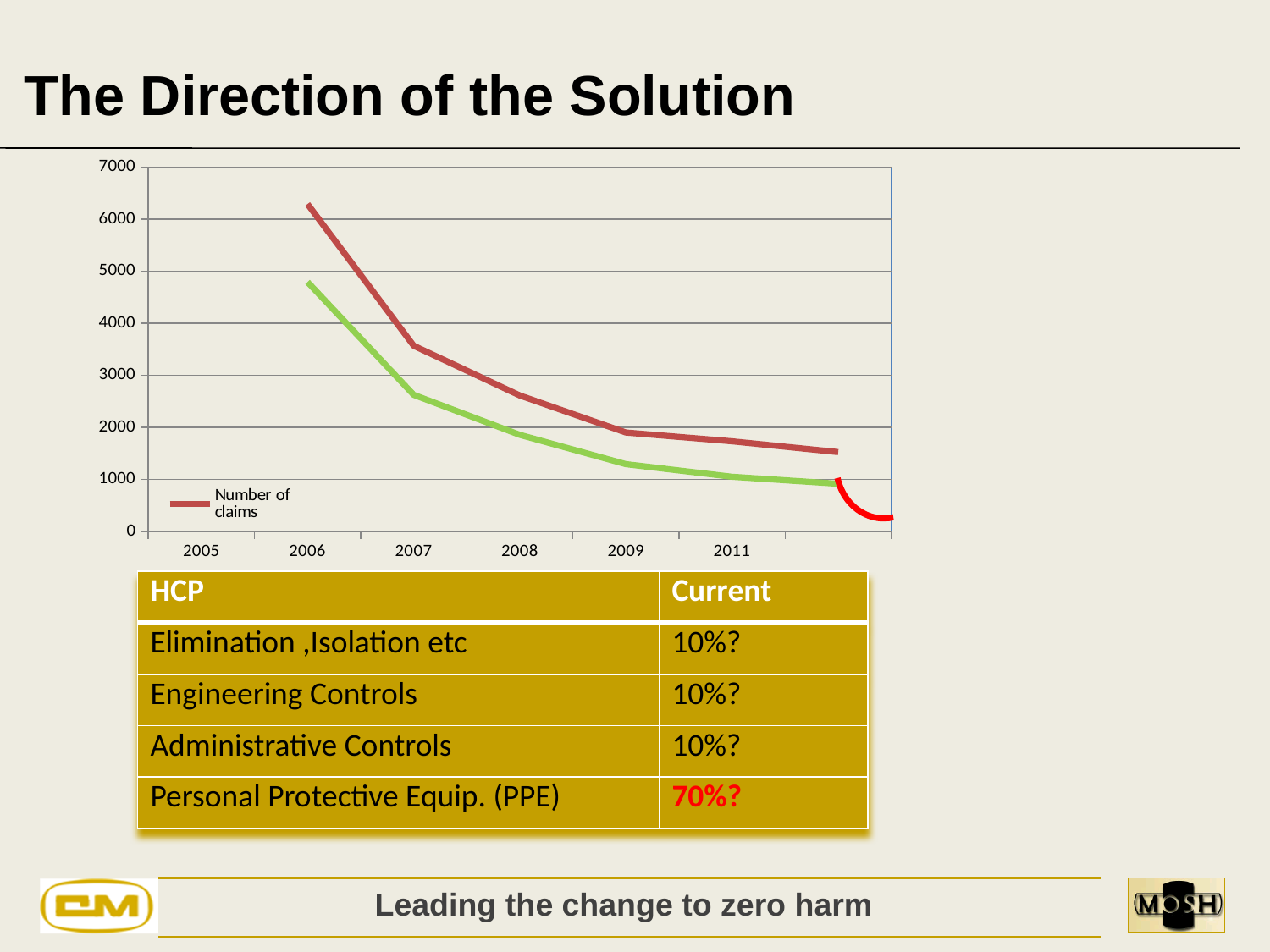
Is the value of the 'Number of claims' line in 2009 greater or less than 3000? less Is the value of the 'Number of claims' line in 2007 greater or less than 3000? greater How many year labels are shown on the x axis of the chart? 6 What is the legend entry shown on the chart? Number of claims What is the highest value shown on the y axis of the chart? 7000 Is the value of the green line in 2011 greater or less than 2000? less How many entries does the chart legend list? 1 What kind of chart is shown on the slide? line chart Do the values of the 'Number of claims' line rise or fall from 2006 to 2011? fall In 2007, which line is higher, the red 'Number of claims' line or the green line? the red 'Number of claims' line